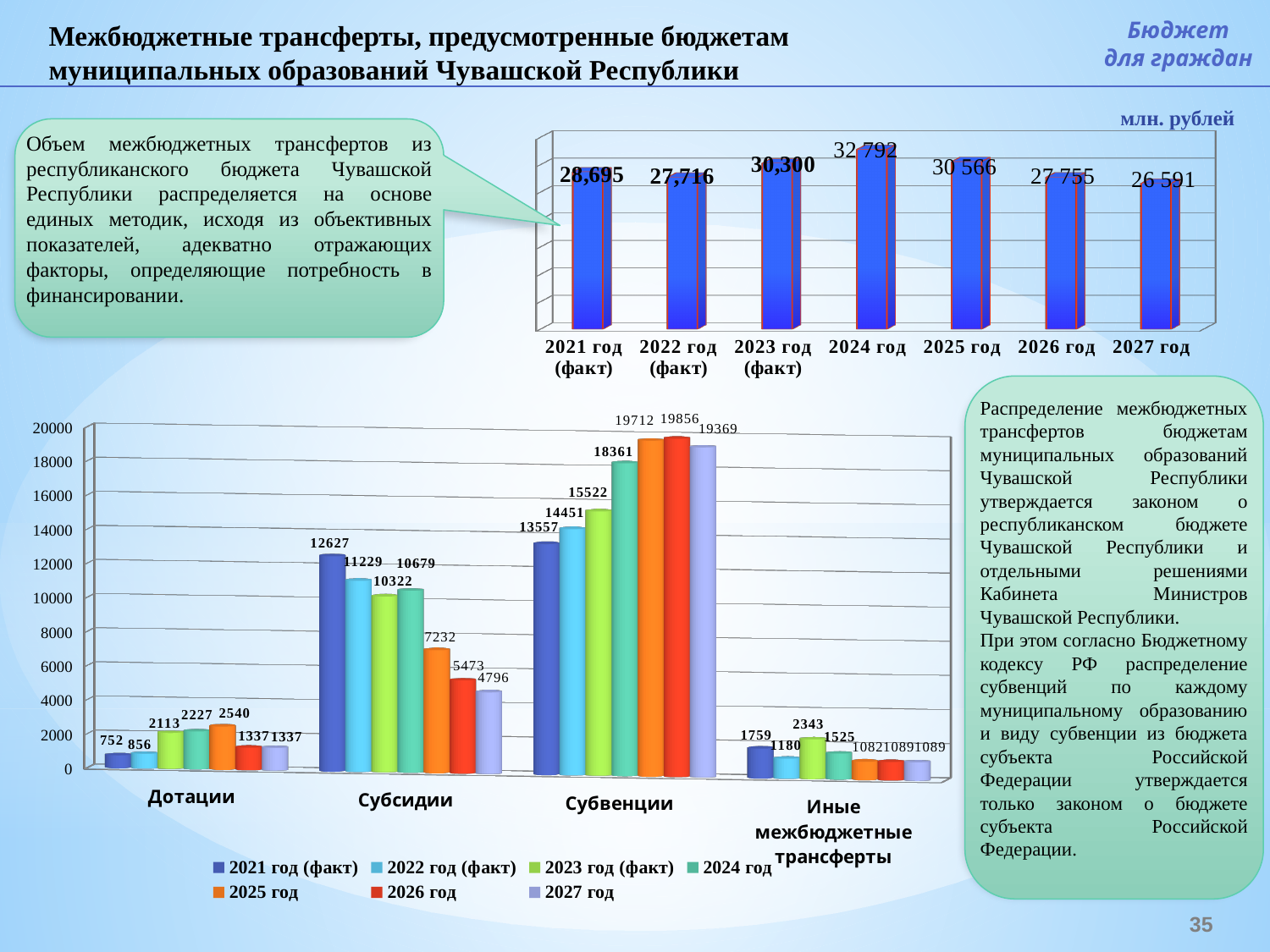
In the bottom chart, how many series does the legend list? 7 What type of chart is the bottom chart? bar chart In the top chart, which year has the lowest value? 2027 год In the bottom chart, what is the difference between Субвенции in 2026 год and Субвенции in 2025 год? 144 In the top chart, how many years are shown on the x axis? 7 In the top chart, what unit is indicated above the chart? млн. рублей In the top chart, what is the value for 2024 год? 32 792 In the top chart, which year has the highest value? 2024 год In the bottom chart, what is the value for Субсидии in 2021 год (факт)? 12627 In the bottom chart, do the values for Субсидии rise or fall from 2021 год (факт) to 2027 год? fall In the bottom chart, what is the value for Субвенции in 2024 год? 18361 In the top chart, what is the value for 2021 год (факт)? 28,695